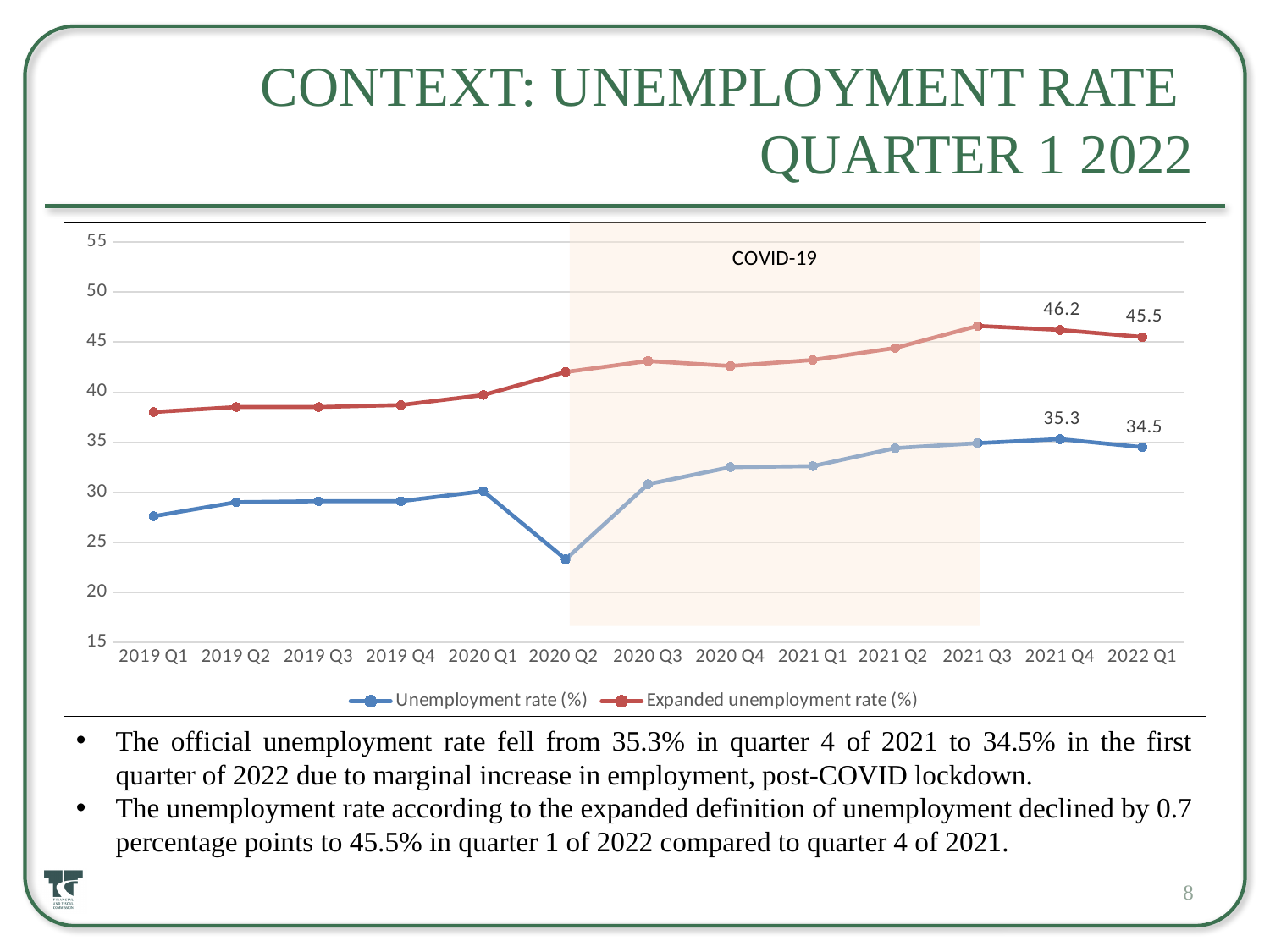
In 2022 Q1, which series has the higher value: Unemployment rate (%) or Expanded unemployment rate (%)? Expanded unemployment rate (%) By how much did the Expanded unemployment rate (%) change from 2021 Q4 to 2022 Q1? 0.7 Is the Unemployment rate (%) for 2020 Q2 greater or less than 25? less What is the Unemployment rate (%) for 2022 Q1? 34.5 What kind of chart is shown on the slide? line chart Is the Expanded unemployment rate (%) for 2019 Q1 greater or less than 40? less What is the Expanded unemployment rate (%) for 2021 Q4? 46.2 What is the difference between the Unemployment rate (%) in 2021 Q4 and 2022 Q1? 0.8 What is the Expanded unemployment rate (%) for 2022 Q1? 45.5 How many series does the chart legend list? 2 How many quarters are shown on the x axis of the chart? 13 What is the Unemployment rate (%) for 2021 Q4? 35.3